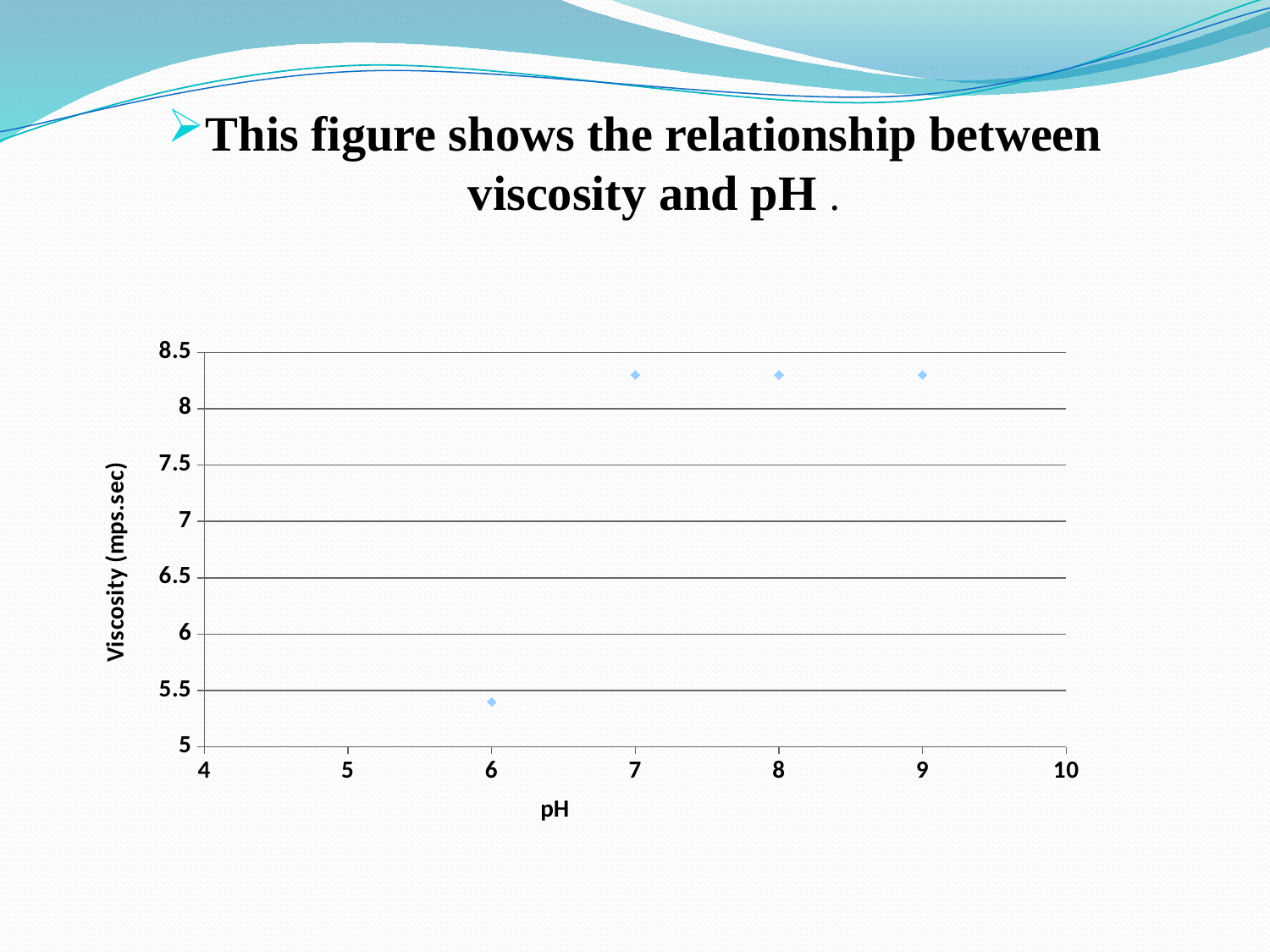
What is the label on the x axis of the chart? pH Is the viscosity at pH 6 greater or less than 6? less Is the viscosity at pH 7 greater or less than 8? greater At which pH value is the viscosity lowest? 6 Is the viscosity at pH 8 greater or less than 7? greater What is the label on the y axis of the chart? Viscosity (mps.sec) Which has the higher viscosity, pH 6 or pH 8? pH 8 What kind of chart is shown on the slide? scatter chart How many data points are plotted on the chart? 4 Does the viscosity rise or fall from pH 6 to pH 7? rise